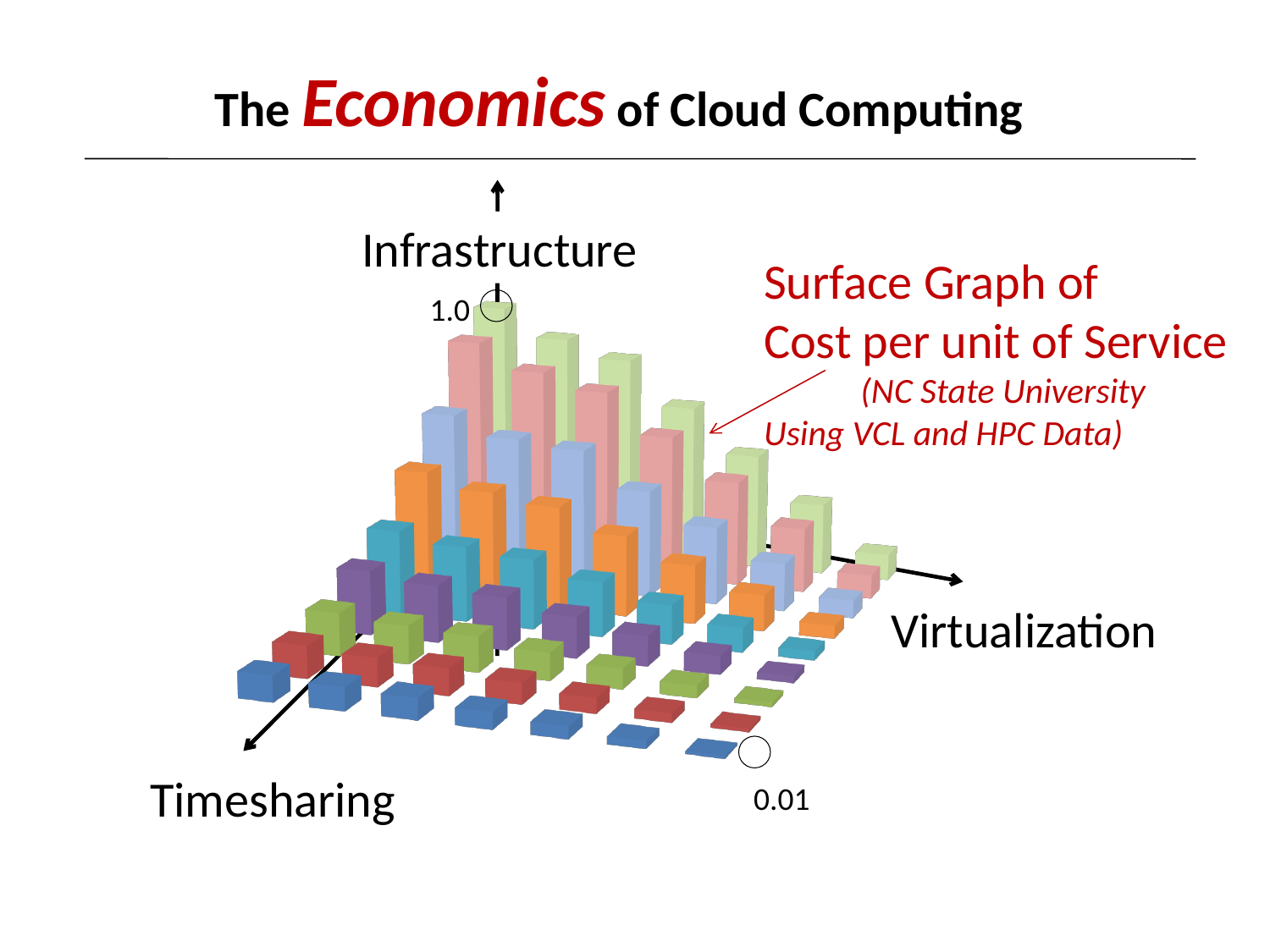
Do the bars get taller or shorter moving along the Virtualization axis in the direction of its arrow? shorter What value is printed next to the shortest bar at the front corner of the chart? 0.01 Which is larger, the value labelled at the back corner bar or the value labelled at the front corner bar? the back corner bar (1.0) What kind of chart is shown on the slide? bar chart What is the title of the chart on the slide? Surface Graph of Cost per unit of Service Do the bars get taller or shorter moving along the Timesharing axis in the direction of its arrow? shorter Which label is on the vertical axis of the chart? Infrastructure What value is printed next to the tallest bar at the back corner of the chart? 1.0